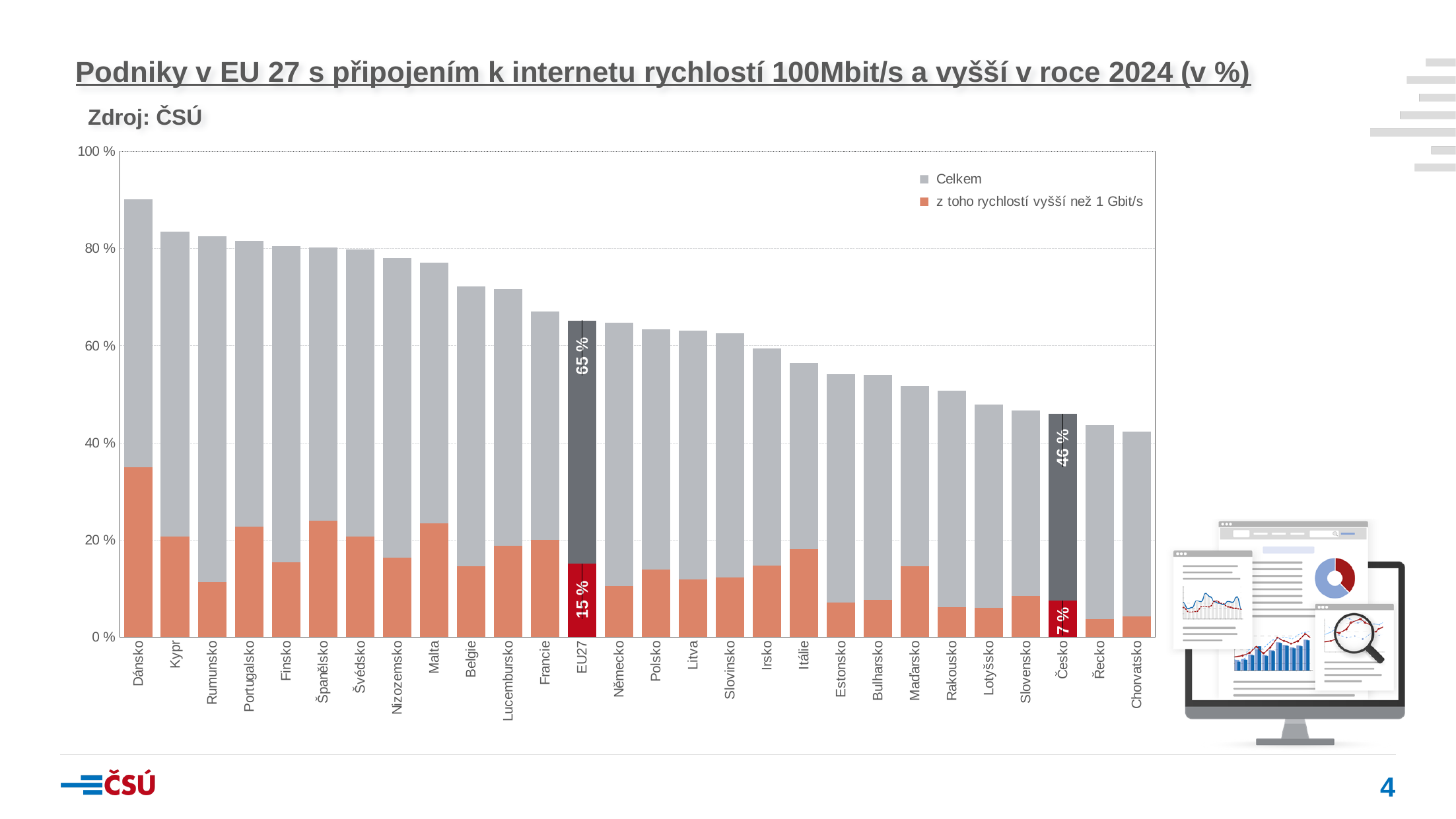
Do the Celkem values rise or fall from left to right along the x axis? fall How many series does the legend list? 2 Is the Celkem value for Dánsko greater or less than 80 %? greater Which country has the lowest Celkem value? Chorvatsko What is the value for EU27 in the series 'z toho rychlostí vyšší než 1 Gbit/s'? 15 % Is the Celkem value for Chorvatsko greater or less than 60 %? less Which country has the highest Celkem value? Dánsko What is the Celkem value for EU27? 65 % What is the value for Česko in the series 'z toho rychlostí vyšší než 1 Gbit/s'? 7 % What is the Celkem value for Česko? 46 % By how many percentage points does the Celkem value for EU27 exceed that for Česko? 19 percentage points How many categories are shown on the x axis? 28